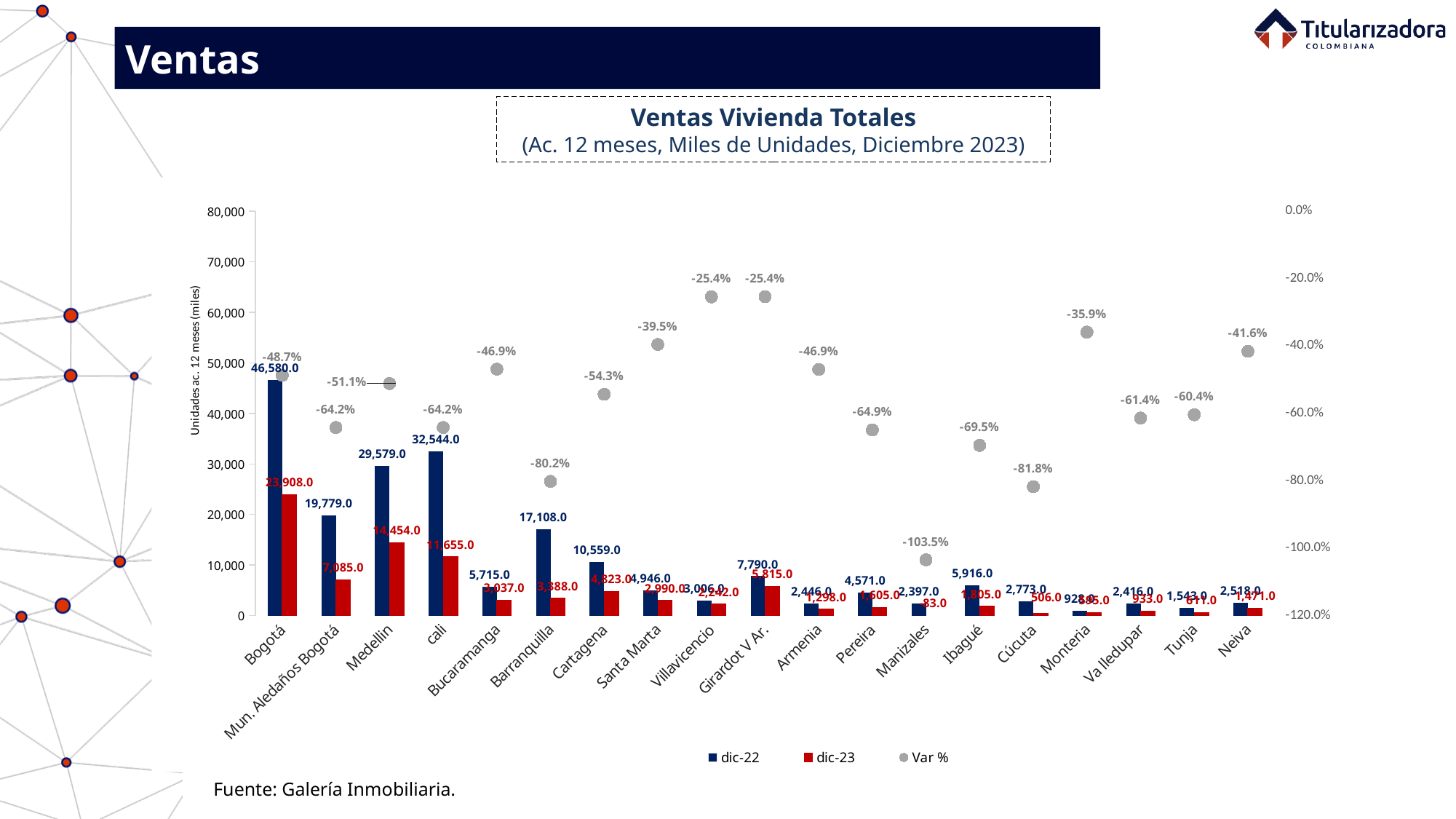
What is the title of the chart? Ventas Vivienda Totales (Ac. 12 meses, Miles de Unidades, Diciembre 2023) Which city has the lowest dic-23 value? Manizales Is the dic-22 value for Barranquilla greater or less than 10,000? greater Which has the larger dic-22 value, Medellin or cali? cali What kind of chart is used to show the dic-22 and dic-23 values? Bar chart How many cities are shown on the x axis? 19 What is the dic-23 value for Medellin? 14,454.0 Which city has the highest dic-22 value? Bogotá What is the difference between the dic-22 and dic-23 values for Bogotá? 22,672.0 What is the dic-22 value for Bogotá? 46,580.0 What is the Var % value shown for Manizales? -103.5% How many series does the legend list? 3